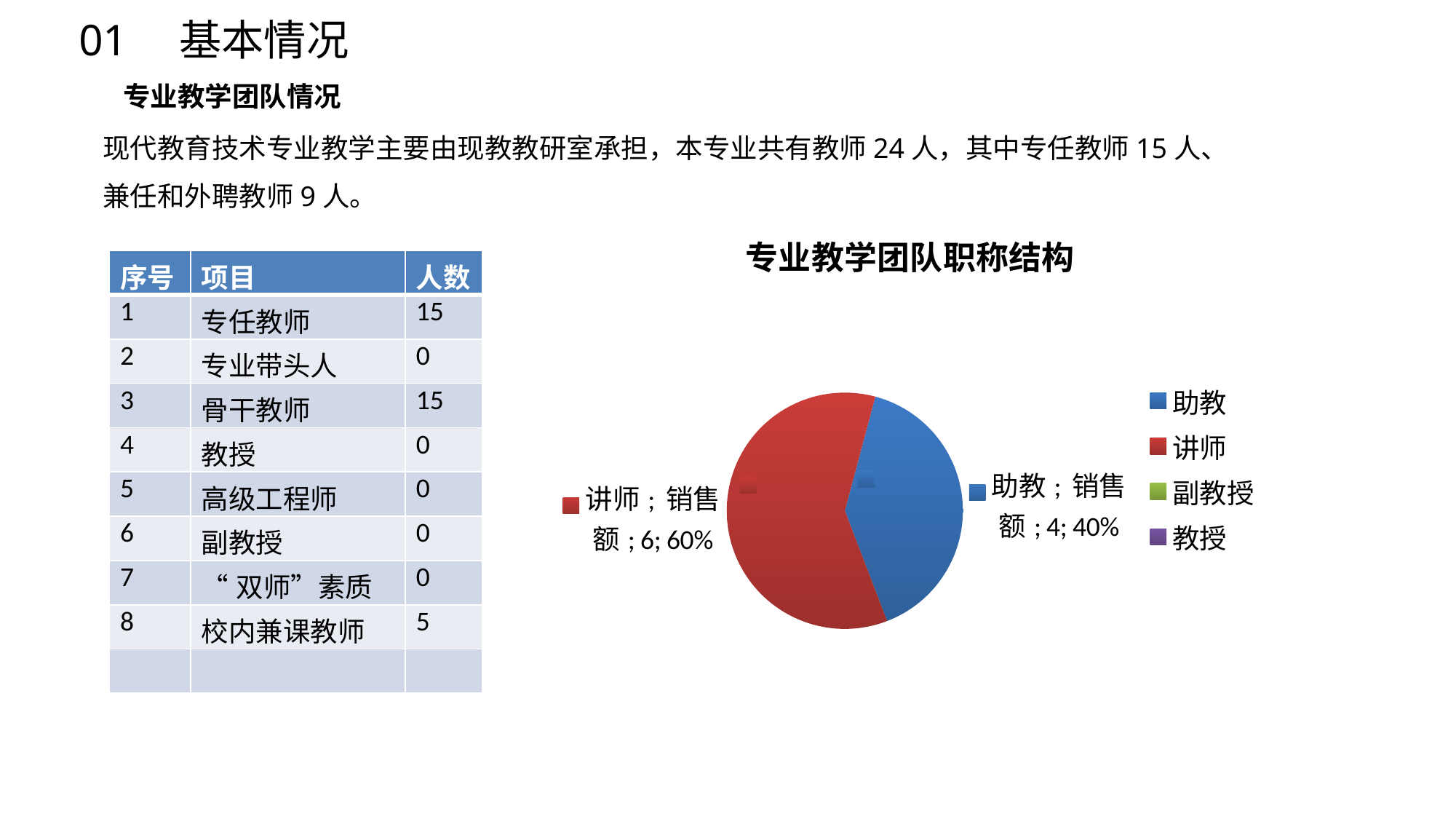
What share of the pie does 助教 represent? 40% How many categories does the legend of the pie chart list? 4 Which category has the largest slice in the pie chart? 讲师 What is the title of the chart? 专业教学团队职称结构 What is the value for 讲师 in the pie chart? 6 What is the name of the data series shown in the pie chart's data labels? 销售额 What share of the pie does 讲师 represent? 60% What is the value for 助教 in the pie chart? 4 What kind of chart is shown on the slide? pie chart Which is larger, the value for 讲师 or the value for 助教? 讲师 How many data series does the pie chart plot? 1 What is the difference between the values for 讲师 and 助教? 2